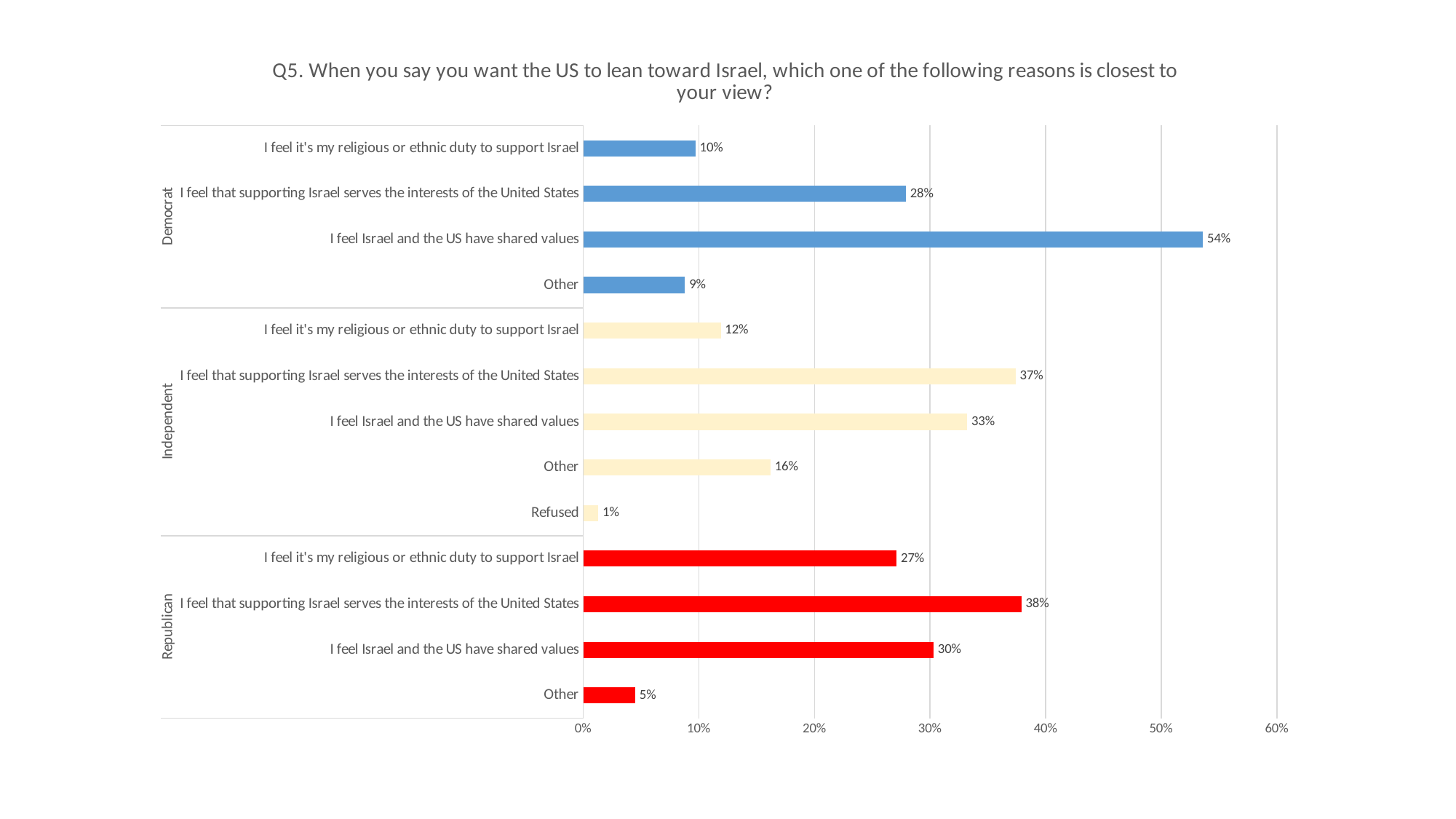
What colour are the bars for the Republican group? Red What percentage of Republicans said they feel it's their religious or ethnic duty to support Israel? 27% Which reason has the highest percentage among Independents? I feel that supporting Israel serves the interests of the United States What percentage of Democrats said they feel Israel and the US have shared values? 54% Is the Democrat value for 'I feel Israel and the US have shared values' greater or less than 50%? greater Which reason has the lowest percentage among Republicans? Other What percentage of Independents chose 'Refused'? 1% What is the difference between the Democrat and Republican percentages for 'I feel Israel and the US have shared values'? 24% How many bars are plotted in the chart? 13 What is the highest value shown on the x axis? 60% Which is larger: the Independent or the Republican percentage for 'I feel that supporting Israel serves the interests of the United States'? Republican What type of chart is shown on the slide? Bar chart